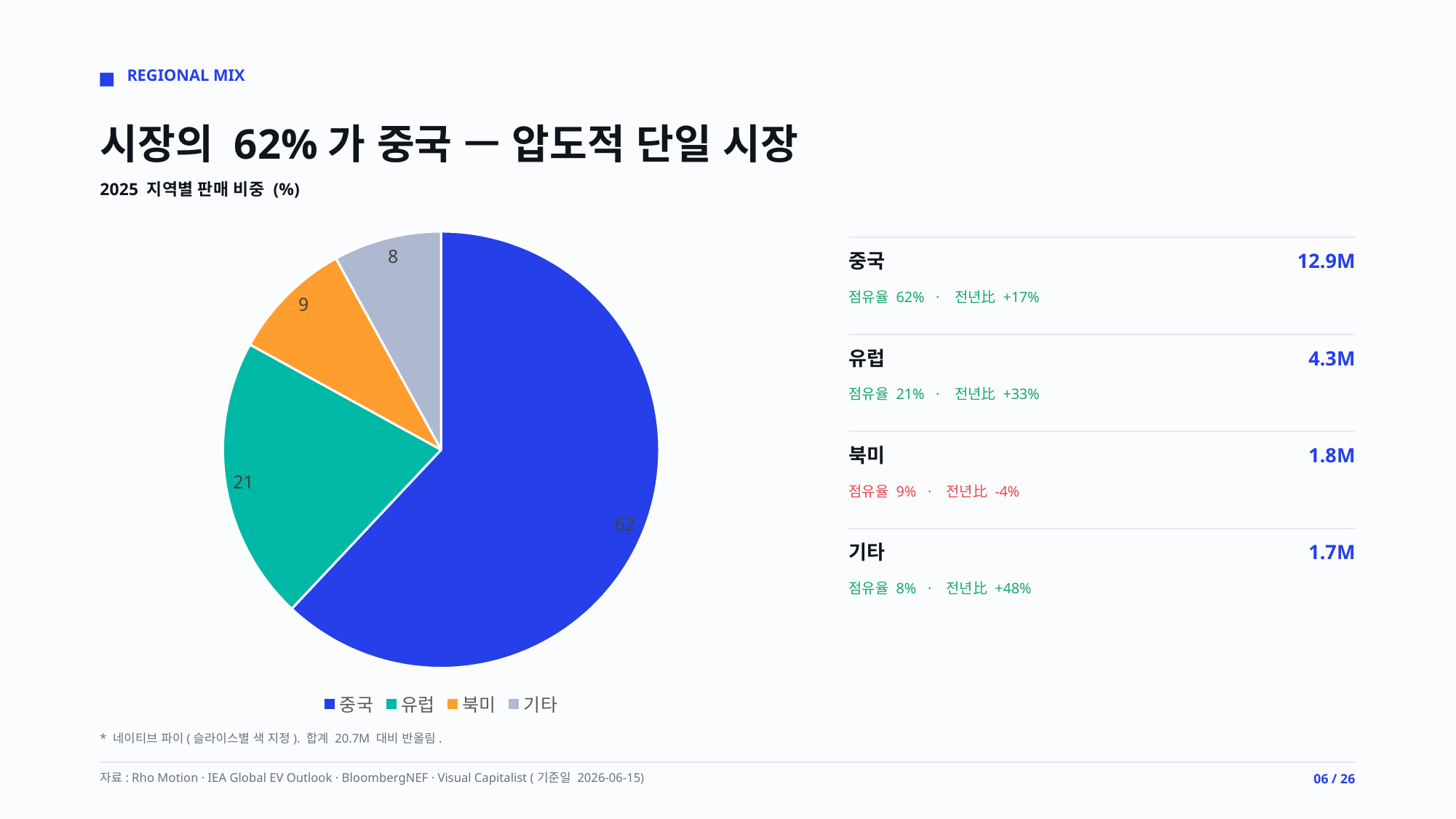
Which is larger in the pie chart, 유럽 or 북미? 유럽 How many slices does the pie chart have? 4 What is the title of the pie chart? 2025 지역별 판매 비중 (%) What kind of chart is shown on the slide? pie chart Which slice of the pie chart is the largest? 중국 How many entries does the pie chart's legend list? 4 What is the value shown for 북미 in the pie chart? 9 What is the value shown for 중국 in the pie chart? 62 What is the difference between the values for 중국 and 유럽 in the pie chart? 41 Which slice of the pie chart is the smallest? 기타 What is the value shown for 유럽 in the pie chart? 21 What is the value shown for 기타 in the pie chart? 8